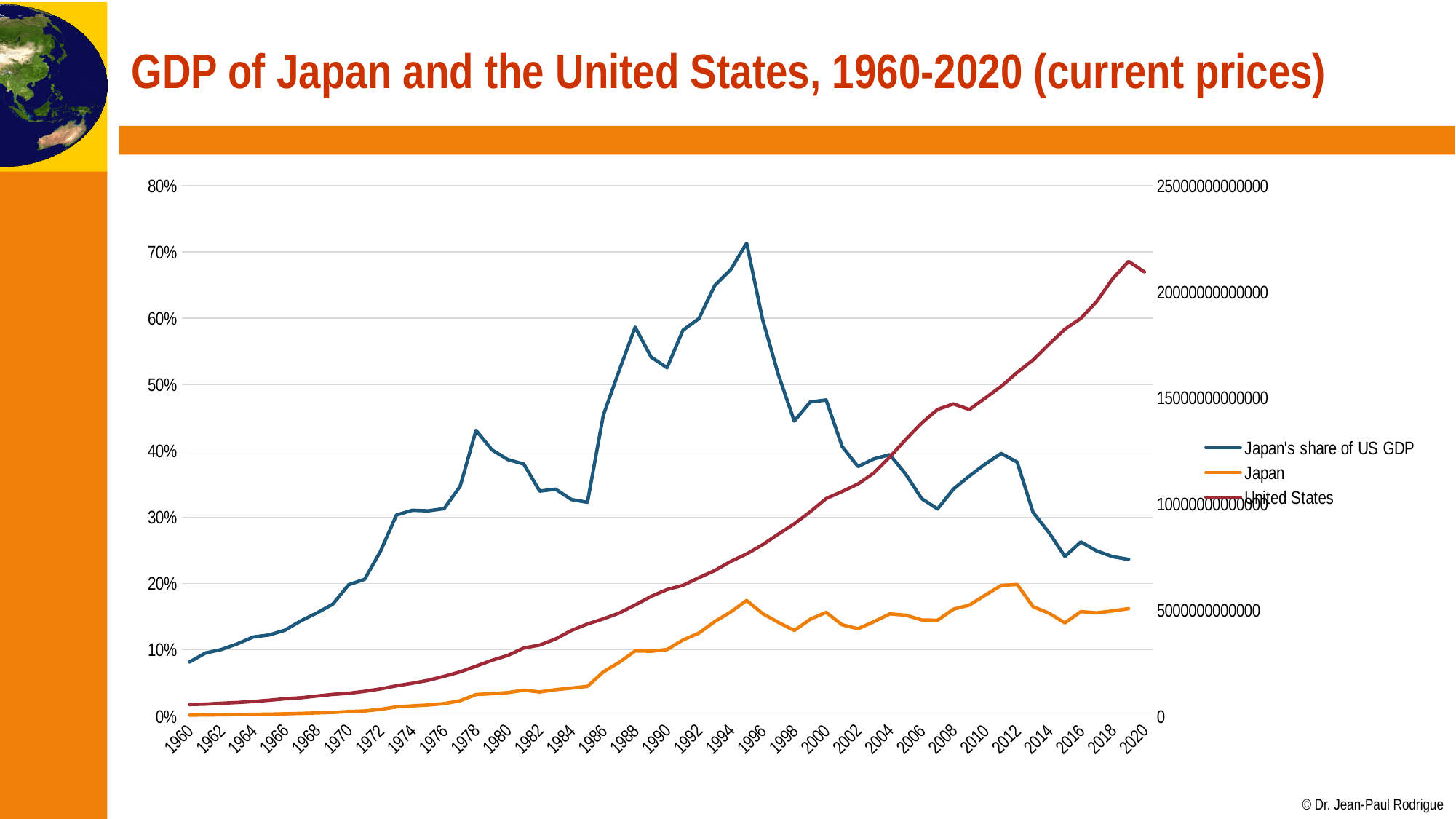
Is the value for Japan's share of US GDP in 1960 greater or less than 10%? less Is the value for United States GDP in 2020 greater or less than 20000000000000? greater Is the value for Japan's share of US GDP in 1995 greater or less than 60%? greater What are the three series named in the legend? Japan's share of US GDP, Japan, United States How many year labels are shown on the x axis? 31 What kind of chart is shown on the slide? line chart Does Japan's share of US GDP rise or fall overall from 1995 to 2020? fall How many series does the legend list? 3 Does the United States GDP line rise or fall overall from 1960 to 2020? rise What is the title of the slide? GDP of Japan and the United States, 1960-2020 (current prices)